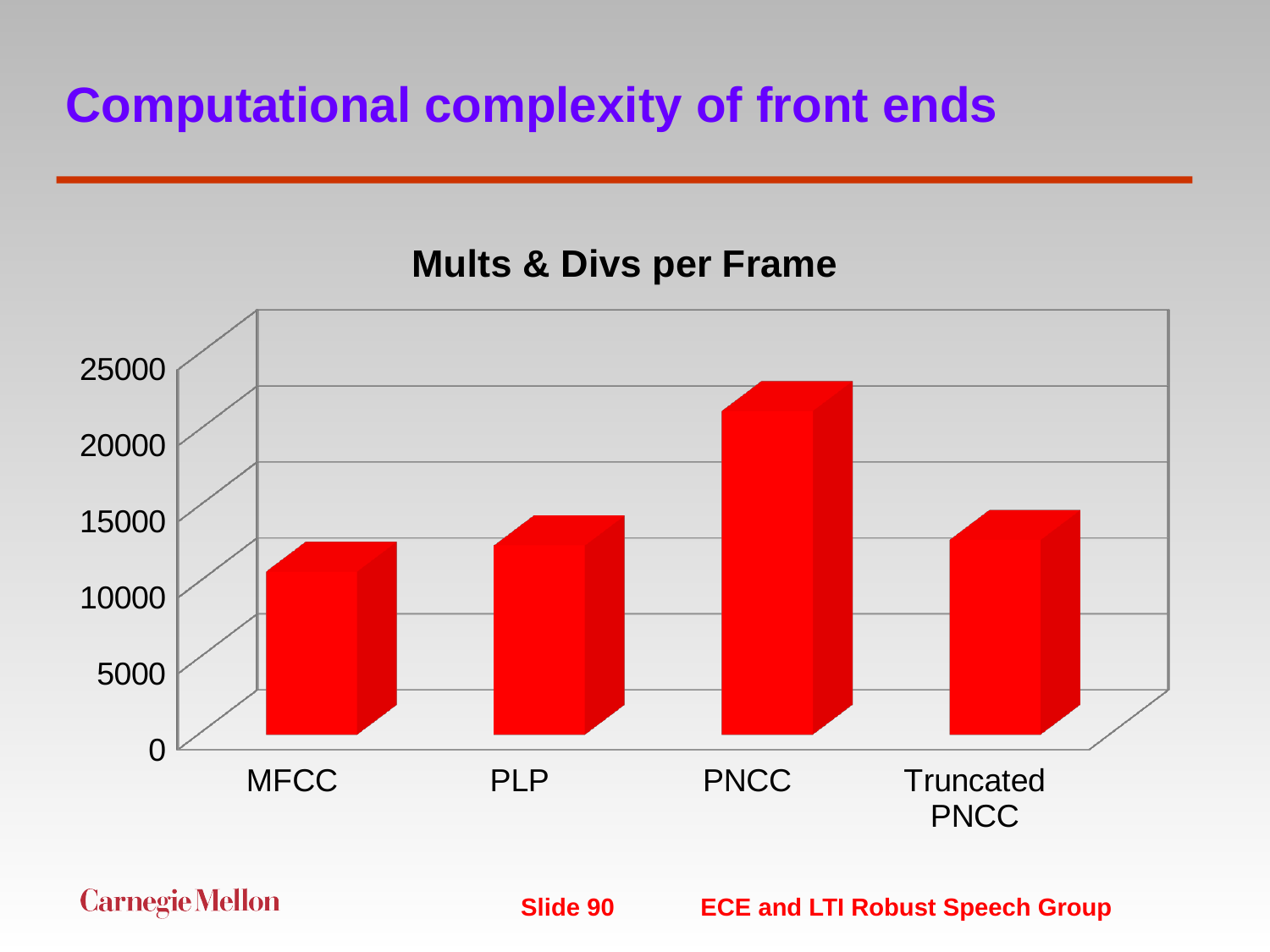
How many front ends (categories) are shown on the x axis? 4 Is the value for MFCC greater or less than 10000? greater Is the value for PNCC greater or less than 25000? less Which is larger, the value for PNCC or the value for Truncated PNCC? PNCC Which is larger, the value for MFCC or the value for PLP? PLP Which front end has the lowest number of mults & divs per frame? MFCC What is the title of the chart? Mults & Divs per Frame Which front end has the highest number of mults & divs per frame? PNCC What kind of chart is shown on the slide? bar chart Is the value for PNCC greater or less than 20000? greater